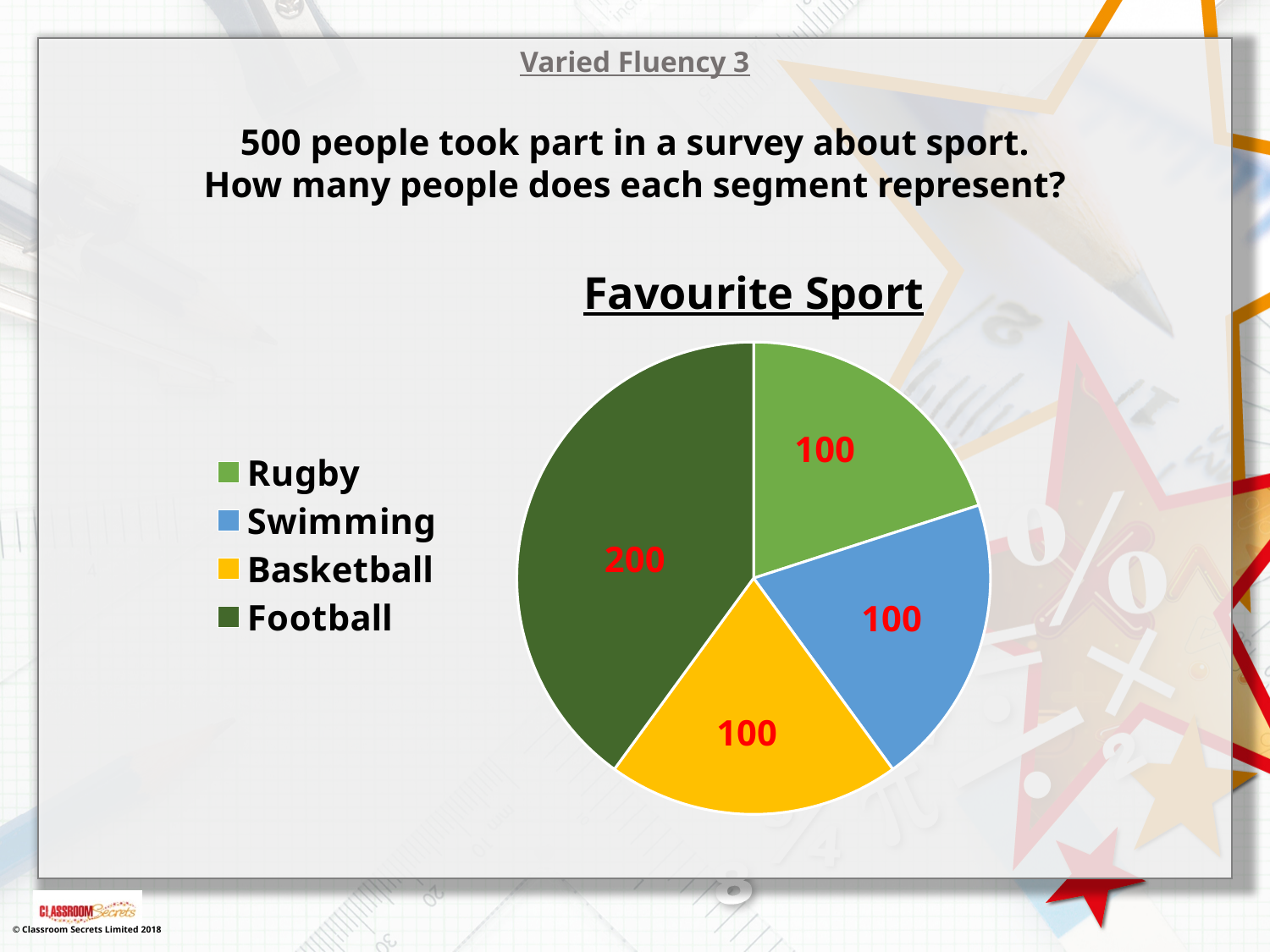
What kind of chart is shown on the slide? pie chart What value is shown for the Swimming segment? 100 What is the title of the chart? Favourite Sport What share of the pie does the Football segment represent? 40% Which is larger, the Football segment or the Swimming segment? Football What value is shown for the Football segment? 200 What value is shown for the Rugby segment? 100 How many entries does the legend list? 4 How many segments does the pie chart have? 4 What colour is the Basketball segment? yellow Which sport has the largest segment in the pie chart? Football What is the difference between the Football value and the Basketball value? 100